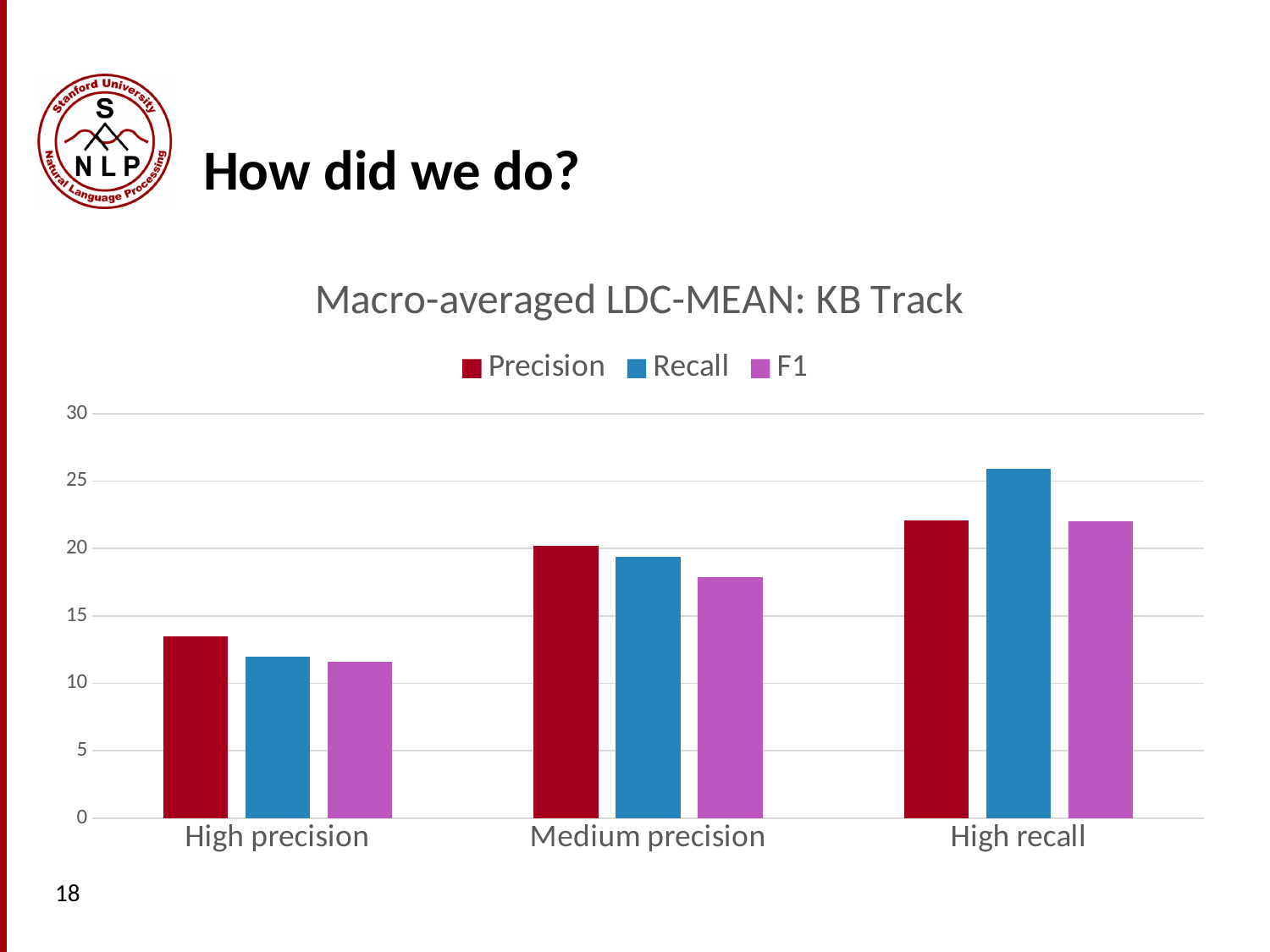
How many categories are shown on the x axis? 3 In the Medium precision category, which is larger, Precision or F1? Precision Which category has the highest Recall value? High recall Do the Precision values rise or fall from High precision to High recall along the x axis? rise Which category has the lowest F1 value? High precision Which category has the lowest Precision value? High precision What kind of chart is shown on the slide? bar chart In the High recall category, which is larger, Precision or Recall? Recall Is the Recall value for High recall greater or less than 20? greater How many series does the legend list? 3 Is the Precision value for High precision greater or less than 15? less What is the title of the chart? Macro-averaged LDC-MEAN: KB Track